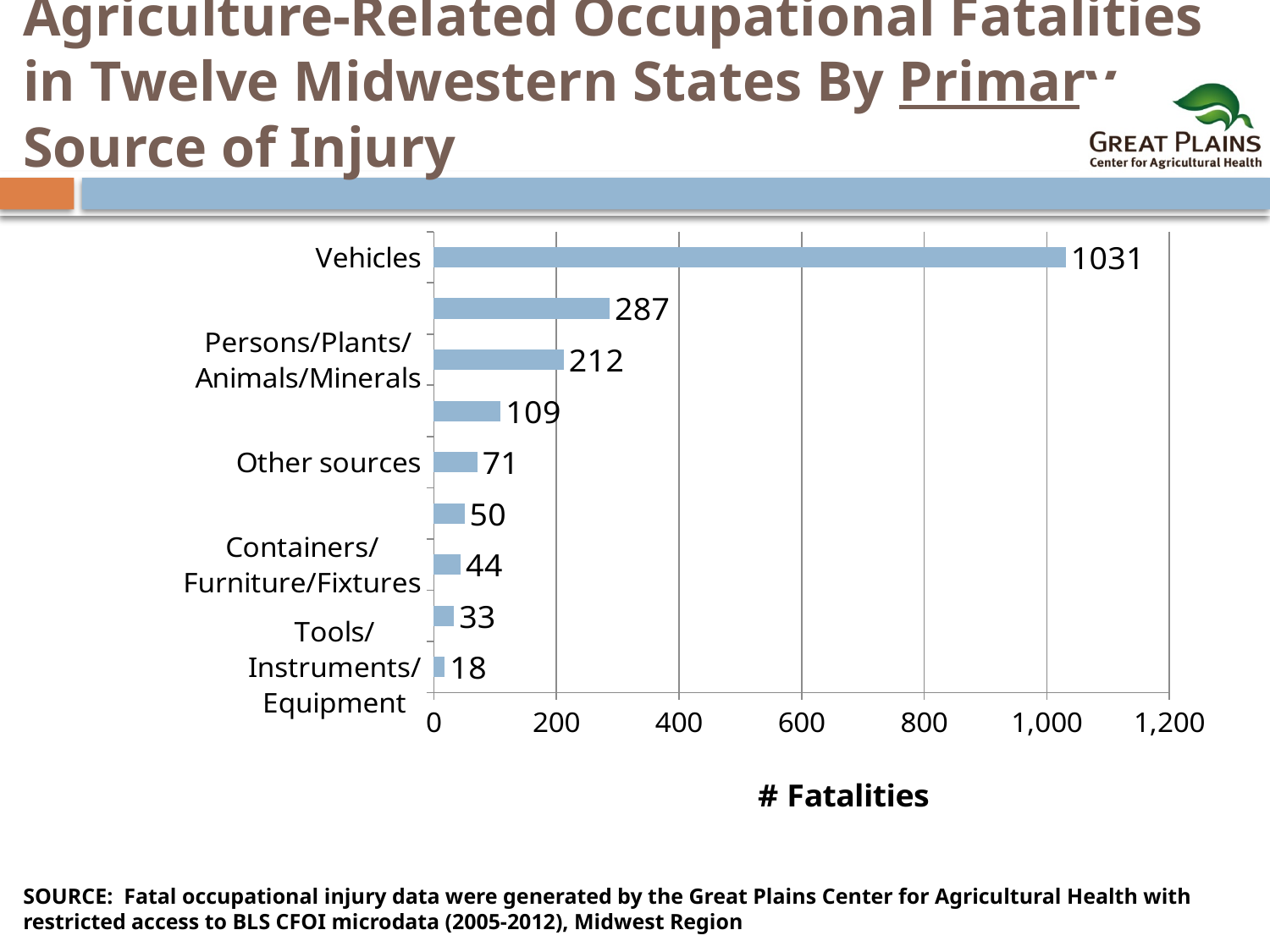
What is the number of fatalities for Other sources? 71 What kind of chart is shown on the slide? Bar chart What is the value for Tools/Instruments/Equipment? 18 Which labeled source of injury has the lowest number of fatalities? Tools/Instruments/Equipment Which has more fatalities, Other sources or Containers/Furniture/Fixtures? Other sources Is the value for Vehicles greater or less than 1,000? greater What is the difference in fatalities between Vehicles and Other sources? 960 What value is shown for Persons/Plants/Animals/Minerals? 212 How many bars are plotted in the chart? 9 How many fatalities are shown for Vehicles? 1031 Which primary source of injury has the highest number of fatalities? Vehicles How many fatalities are shown for Containers/Furniture/Fixtures? 44